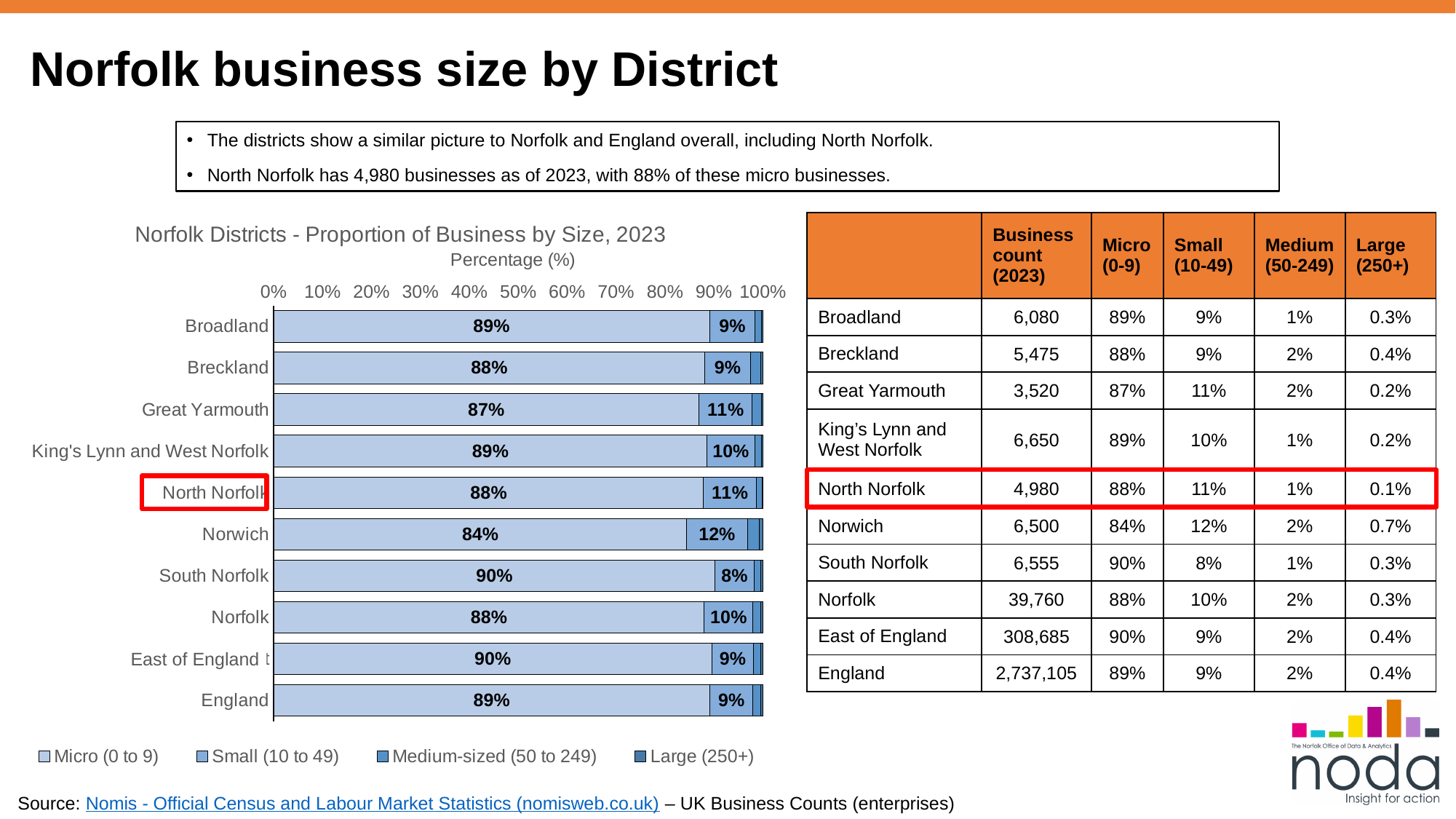
Is the Micro (0 to 9) value for Norwich greater or less than 80%? greater What is the difference between the Micro percentage for South Norfolk and the Micro percentage for Norwich? 6% What is the Micro (0 to 9) percentage for North Norfolk on the chart? 88% What type of chart is shown on the slide? Stacked bar chart How many series does the chart legend list? 4 How many categories (areas) are plotted on the chart? 10 Which is larger on the chart: the Small (10 to 49) percentage for North Norfolk or for South Norfolk? North Norfolk Which area has the lowest Micro (0 to 9) percentage on the chart? Norwich Which area has the highest Small (10 to 49) percentage on the chart? Norwich What is the Small (10 to 49) percentage for Great Yarmouth on the chart? 11% What is the title of the chart? Norfolk Districts - Proportion of Business by Size, 2023 What is the Micro (0 to 9) percentage for Norwich on the chart? 84%